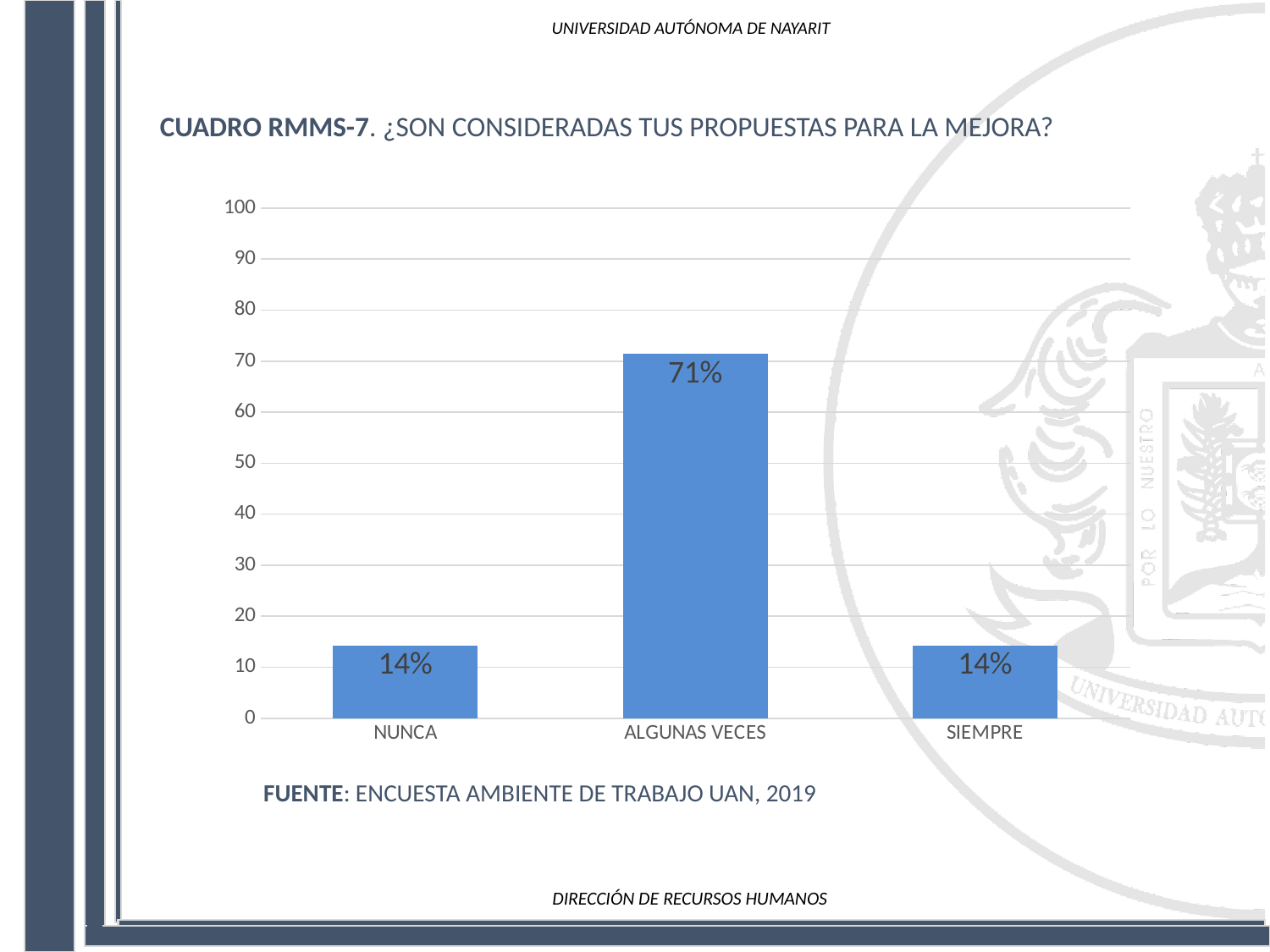
Which is larger, the value for ALGUNAS VECES or the value for SIEMPRE? ALGUNAS VECES Is the value for NUNCA greater or less than 20? less What is the difference between the values for ALGUNAS VECES and NUNCA? 57% What is the value for SIEMPRE? 14% What is the highest value shown on the y axis? 100 What is the source cited below the chart? ENCUESTA AMBIENTE DE TRABAJO UAN, 2019 How many categories are shown on the x axis? 3 Which category has the highest value? ALGUNAS VECES Is the value for ALGUNAS VECES greater or less than 50? greater What is the value for ALGUNAS VECES? 71% What kind of chart is shown on the slide? bar chart What is the value for NUNCA? 14%